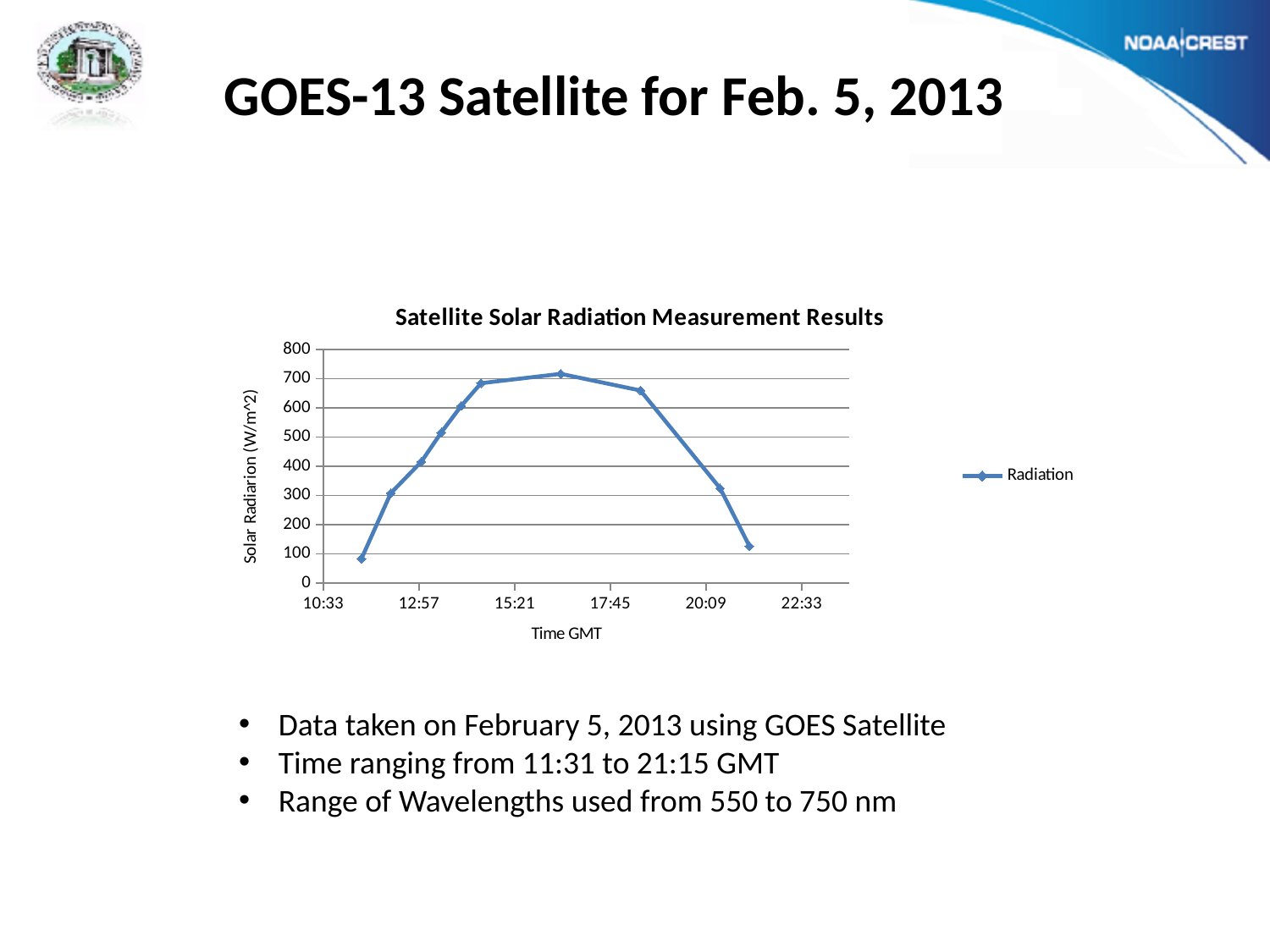
What is the label of the y axis? Solar Radiarion (W/m^2) Which is larger, the first plotted value on the left or the last plotted value on the right? the last plotted value on the right How many data points are plotted on the line? 10 Is the highest radiation value on the chart greater or less than 600? greater Is the first plotted radiation value (leftmost point) greater or less than 200? less What kind of chart is shown on the slide? line chart How many series does the chart legend list? 1 Is the last plotted radiation value (rightmost point) greater or less than 300? less What is the title of the chart? Satellite Solar Radiation Measurement Results Does the radiation value rise or fall from the peak to the last point on the right? fall Does the radiation value rise or fall from the first point to the peak in the middle of the chart? rise What is the name of the series shown in the legend? Radiation